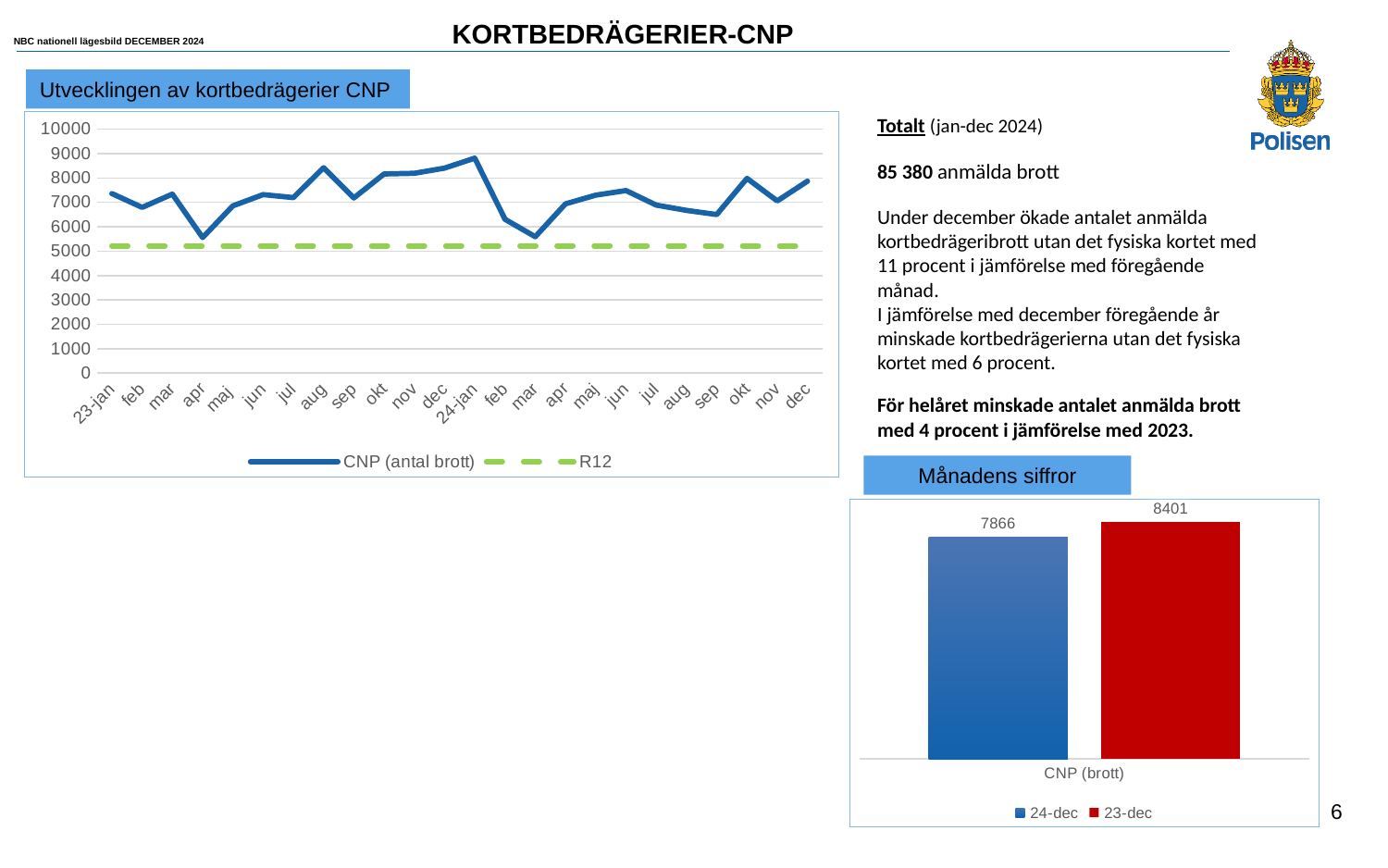
How many months are plotted along the x axis of the 'Utvecklingen av kortbedrägerier CNP' chart? 24 What kind of chart is the 'Utvecklingen av kortbedrägerier CNP' chart? Line chart In the 'Månadens siffror' chart, what is the value for 24-dec? 7866 In the 'Utvecklingen av kortbedrägerier CNP' chart, is the CNP (antal brott) value for apr 2023 greater or less than 6000? less How many series does the legend of the 'Månadens siffror' chart list? 2 In the 'Utvecklingen av kortbedrägerier CNP' chart, which series is drawn as a dashed green line? R12 In the 'Månadens siffror' chart, what is the value for 23-dec? 8401 How many series does the legend of the 'Utvecklingen av kortbedrägerier CNP' chart list? 2 In the 'Månadens siffror' chart, what is the difference between the 23-dec and 24-dec values? 535 In the 'Månadens siffror' chart, which series has the higher value, 24-dec or 23-dec? 23-dec In the 'Utvecklingen av kortbedrägerier CNP' chart, is the CNP (antal brott) value for dec 2023 greater or less than 8000? greater What kind of chart is the 'Månadens siffror' chart? Bar chart